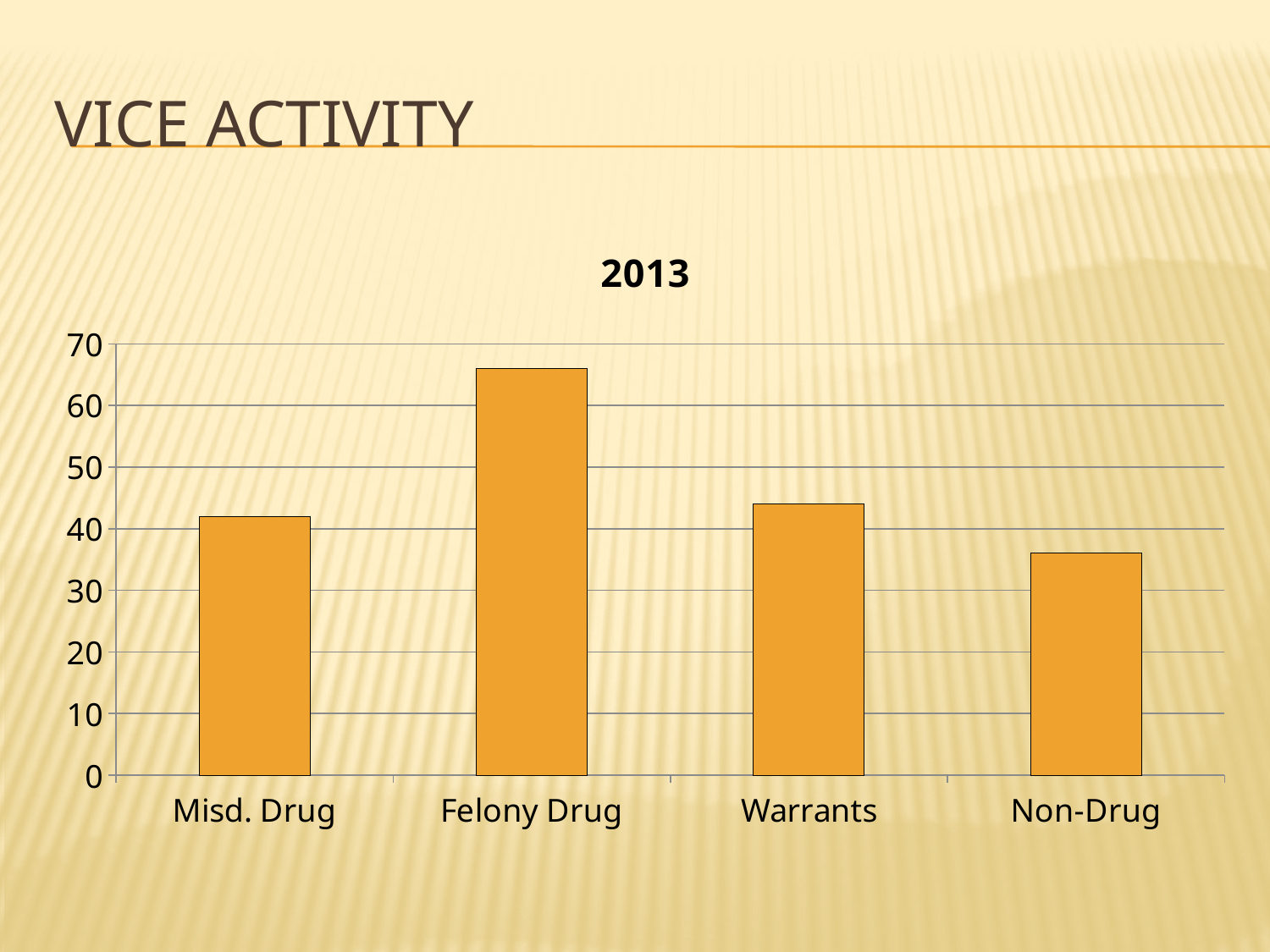
Is the value for Warrants greater or less than 50? less Which category has the lowest value in the chart? Non-Drug What is the title of the chart? 2013 Which category has the highest value in the chart? Felony Drug What type of chart is shown on the slide? bar chart Is the value for Felony Drug greater or less than 60? greater Which is larger, the value for Misd. Drug or the value for Non-Drug? Misd. Drug Is the value for Misd. Drug greater or less than 40? greater What is the highest value shown on the y axis of the chart? 70 How many categories are shown on the x axis of the chart? 4 Which is larger, the value for Felony Drug or the value for Warrants? Felony Drug